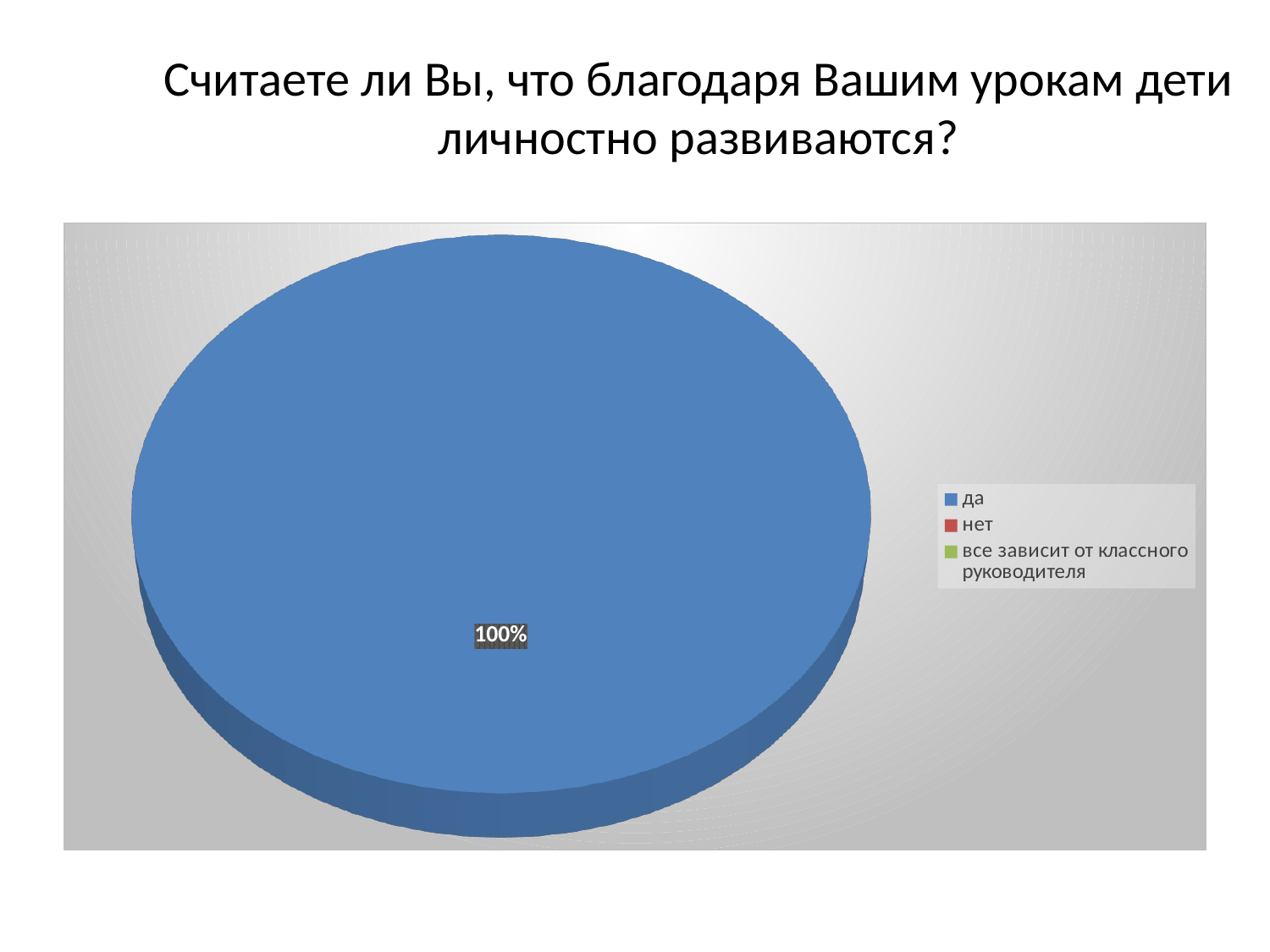
Which is larger, the share for "да" or the share for "нет"? да What is the data label printed on the pie? 100% How many slices are visible in the pie? 1 What kind of chart is shown on the slide? pie chart Which legend entry is shown in blue? да How many entries does the legend list? 3 What share of the pie does the "да" slice take? 100% Which category has the largest share of the pie? да Is the share for "да" greater or less than 50%? greater What is the third entry in the legend? все зависит от классного руководителя